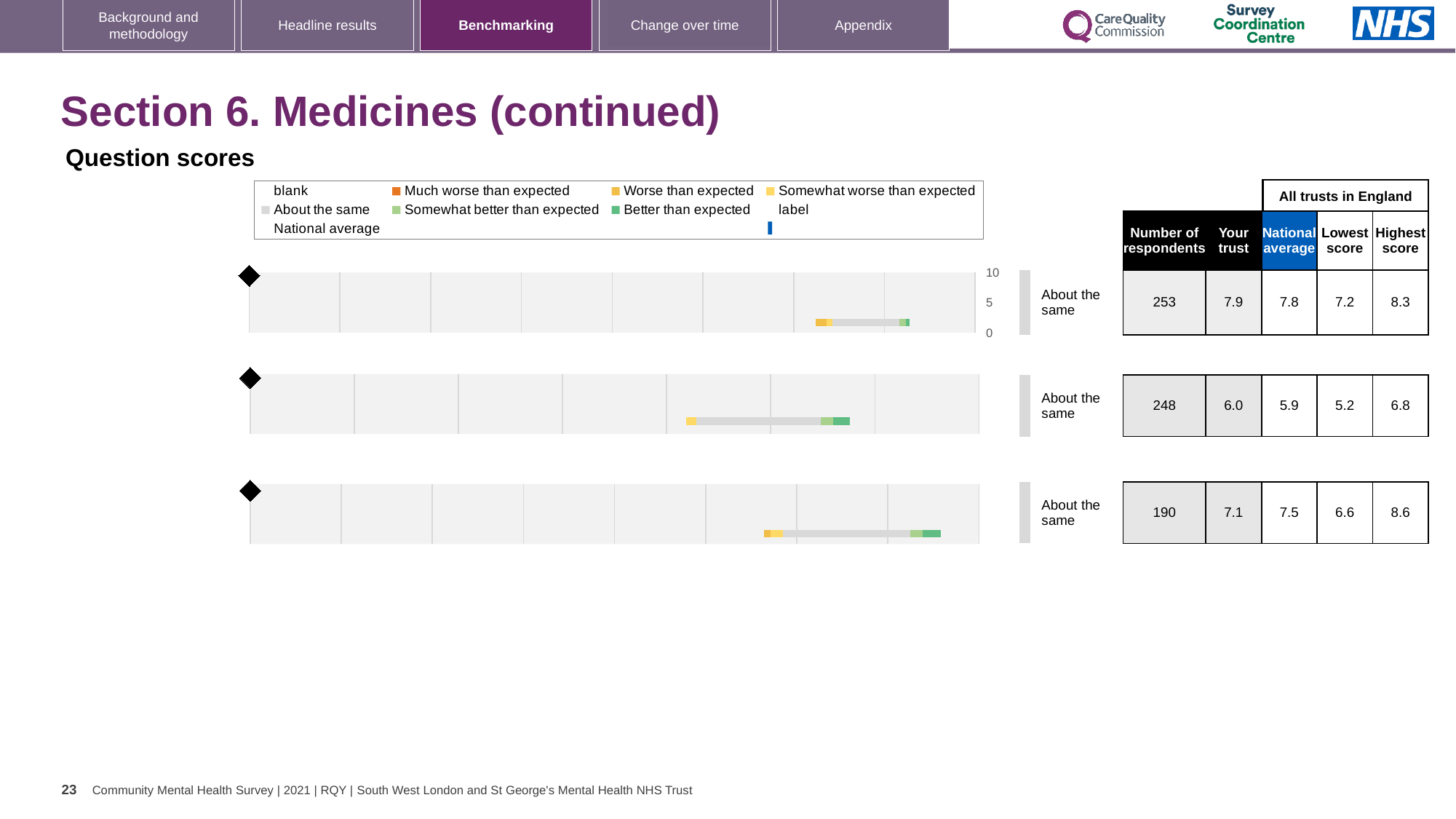
In the top chart, is the trust's score greater or less than 5? greater What is the maximum value shown on the axis of the top chart? 10 What kind of chart is the top chart on the slide? bar chart In the bottom chart, is the trust's score greater or less than 5? greater For the top chart's row in the table, what is the 'Your trust' score? 7.9 What benchmark category is shown next to the middle chart? About the same For the middle chart's row in the table, what is the national average? 5.9 For the top chart's row, which is larger: the 'Your trust' score or the national average? Your trust For the bottom chart's row, what is the difference between the highest score and the lowest score? 2.0 Which chart's row has the highest number of respondents in the table? the top chart (253) For the bottom chart's row in the table, how many respondents are there? 190 How many benchmarking charts are shown on the slide? 3